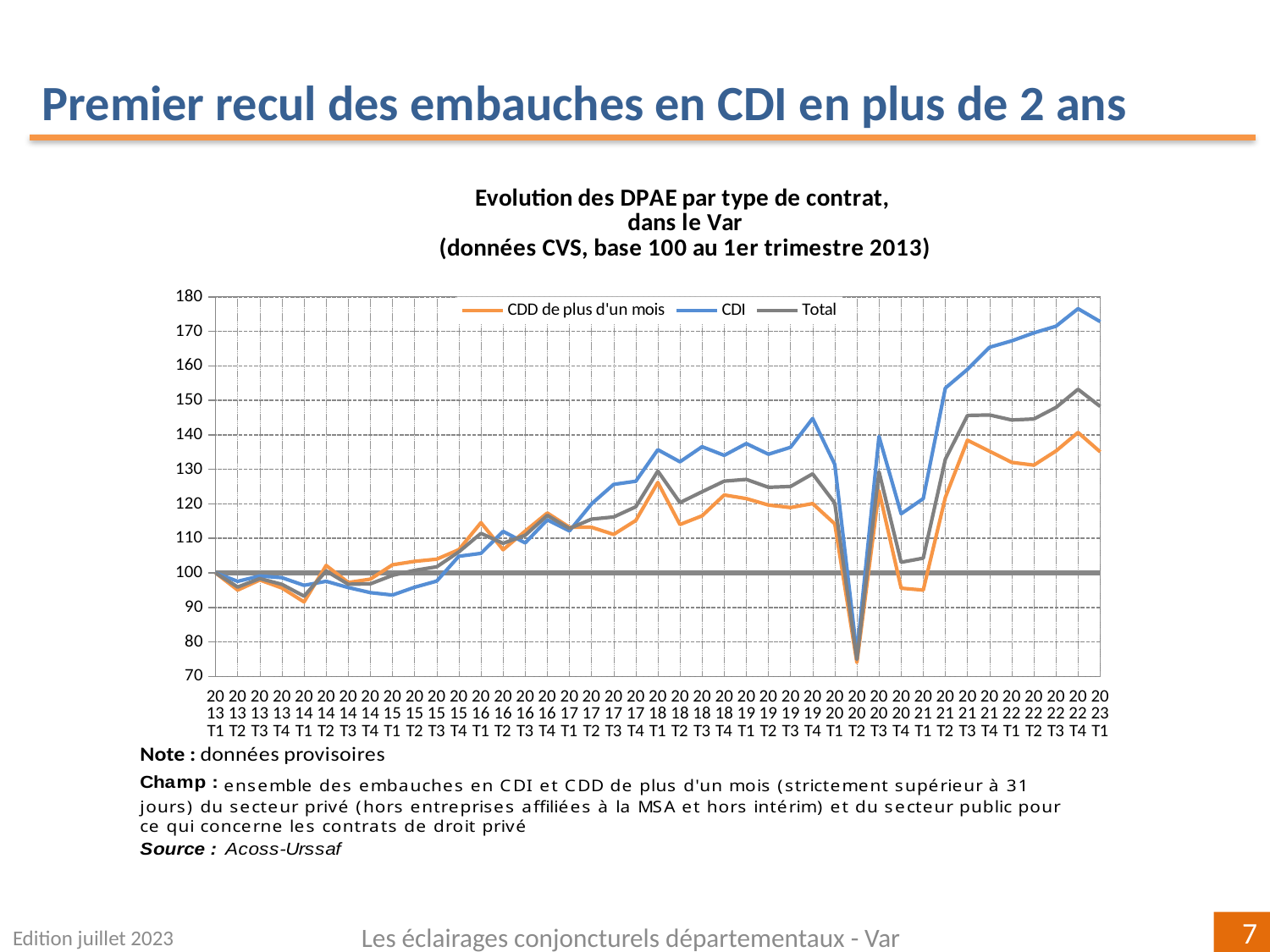
Which colour is used for the CDI series? blue Is the value of the CDI series at 2022 T4 greater or less than 170? greater What kind of chart is shown on the slide? line chart Which series has the lowest value at 2023 T1? CDD de plus d'un mois What is the value of each series at 2013 T1, the base period? 100 Is the value of the CDI series at 2020 T2 greater or less than 80? less Is the value of the Total series at 2022 T4 greater or less than 150? greater Do the three series rise or fall between 2022 T4 and 2023 T1? fall Which series has the highest value at 2023 T1? CDI How many quarterly points are plotted along the x axis? 41 How many series does the legend list? 3